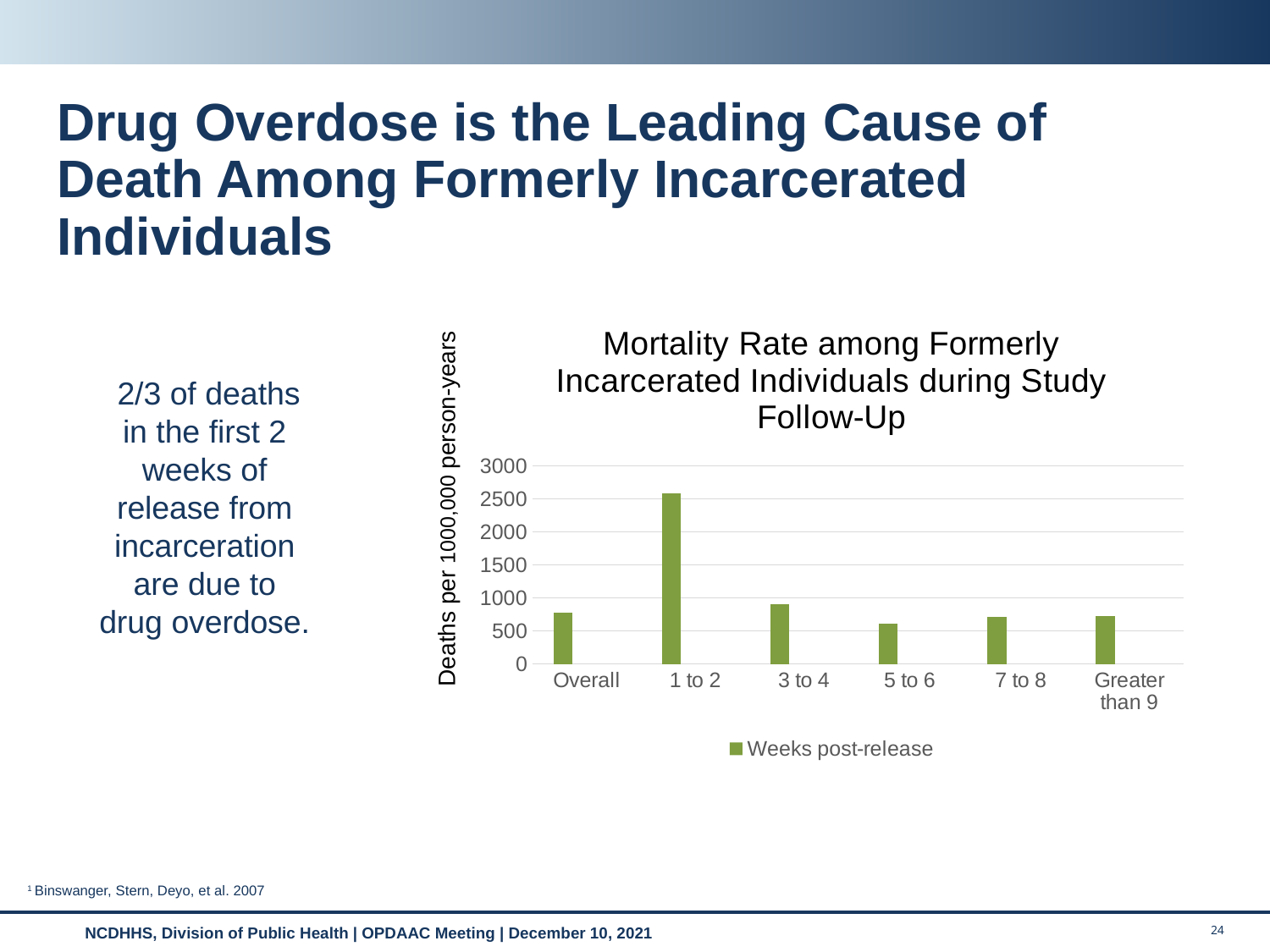
What is the title of the chart? Mortality Rate among Formerly Incarcerated Individuals during Study Follow-Up What kind of chart is shown on the slide? bar chart Which category has the lowest mortality rate in the chart? 5 to 6 Which category has the highest mortality rate in the chart? 1 to 2 Is the value for 5 to 6 weeks post-release greater or less than 500? greater What is the legend entry for the series in the chart? Weeks post-release How many categories are shown on the x axis of the chart? 6 How many series does the chart legend list? 1 Which is larger, the value for 1 to 2 weeks or the value for Overall? 1 to 2 Which is larger, the value for 3 to 4 weeks or the value for 5 to 6 weeks? 3 to 4 Is the value for 1 to 2 weeks post-release greater or less than 2000? greater Is the value for Overall greater or less than 1000? less